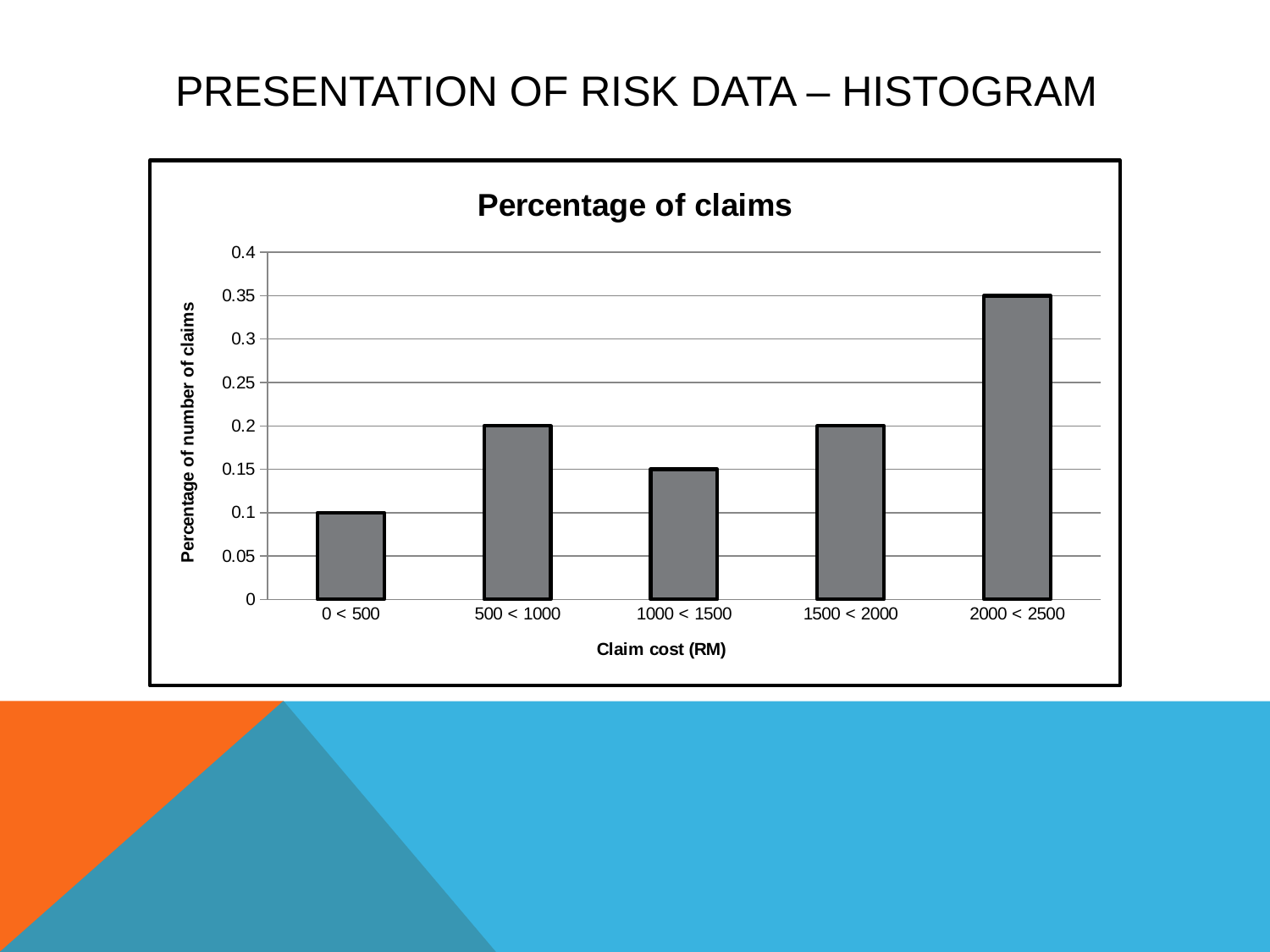
What is the difference between the values for 2000 < 2500 and 0 < 500? 0.25 How many claim cost categories are shown on the chart? 5 Which claim cost category has the highest percentage of claims? 2000 < 2500 What is the value for the 1000 < 1500 claim cost category? 0.15 What is the title of the chart? Percentage of claims Which claim cost category has the lowest percentage of claims? 0 < 500 Which is larger, the value for 500 < 1000 or the value for 1000 < 1500? 500 < 1000 What is the label of the x axis? Claim cost (RM) What kind of chart is shown on the slide? bar chart What is the value for the 0 < 500 claim cost category? 0.1 What is the value for the 2000 < 2500 claim cost category? 0.35 Is the value for 2000 < 2500 greater or less than 0.3? greater